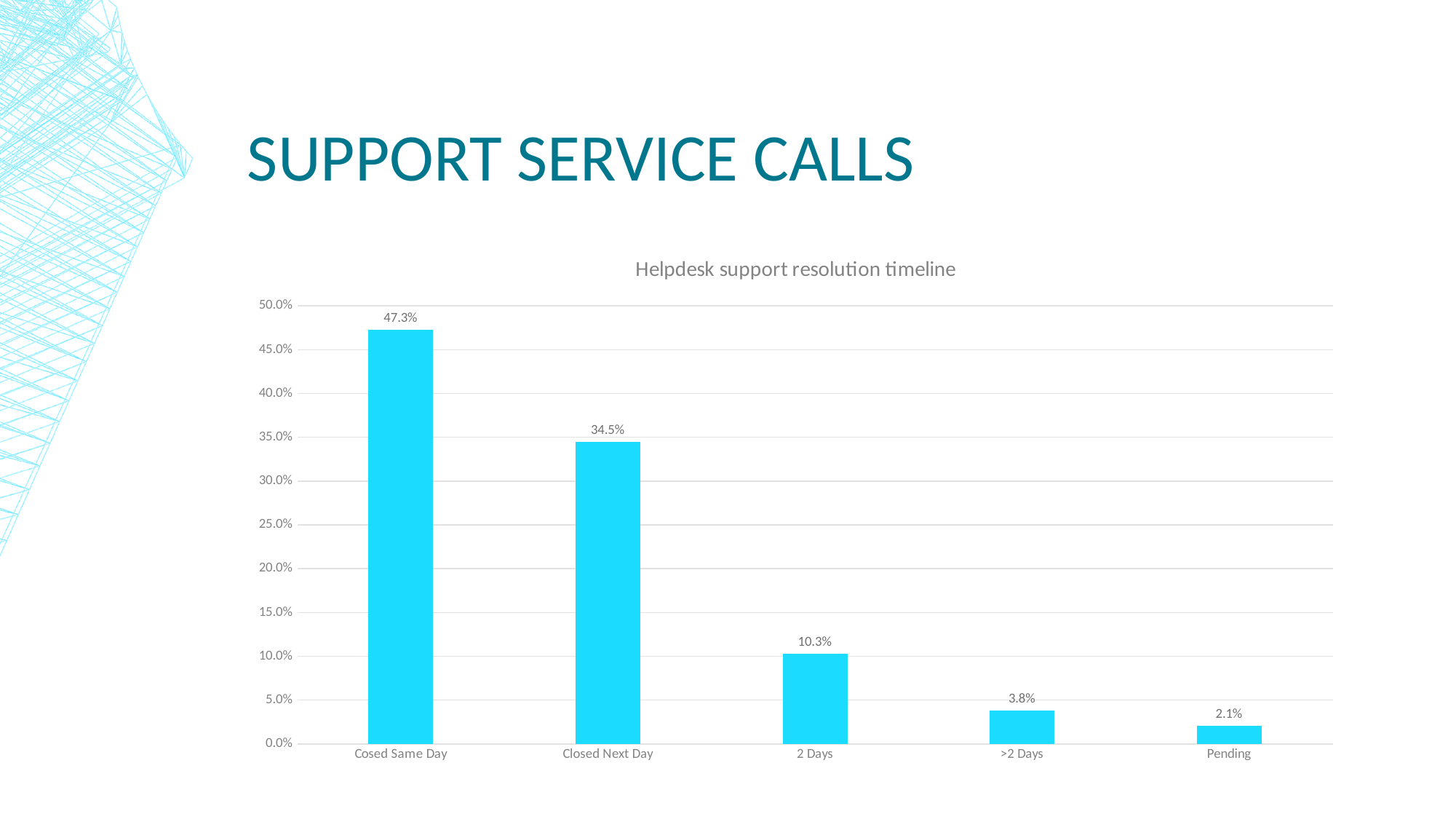
What is the value for Pending? 2.1% Do the values rise or fall from left to right along the x axis? Fall Is the value for 2 Days greater or less than 15.0%? less Which is larger, the value for >2 Days or the value for Pending? >2 Days What kind of chart is shown? Bar chart What is the difference between the values for Cosed Same Day and Closed Next Day? 12.8% What is the title of the chart? Helpdesk support resolution timeline What is the value for Closed Next Day? 34.5% How many categories are shown on the x axis? 5 What is the value for 2 Days? 10.3% Which category has the highest value? Cosed Same Day Which category has the lowest value? Pending